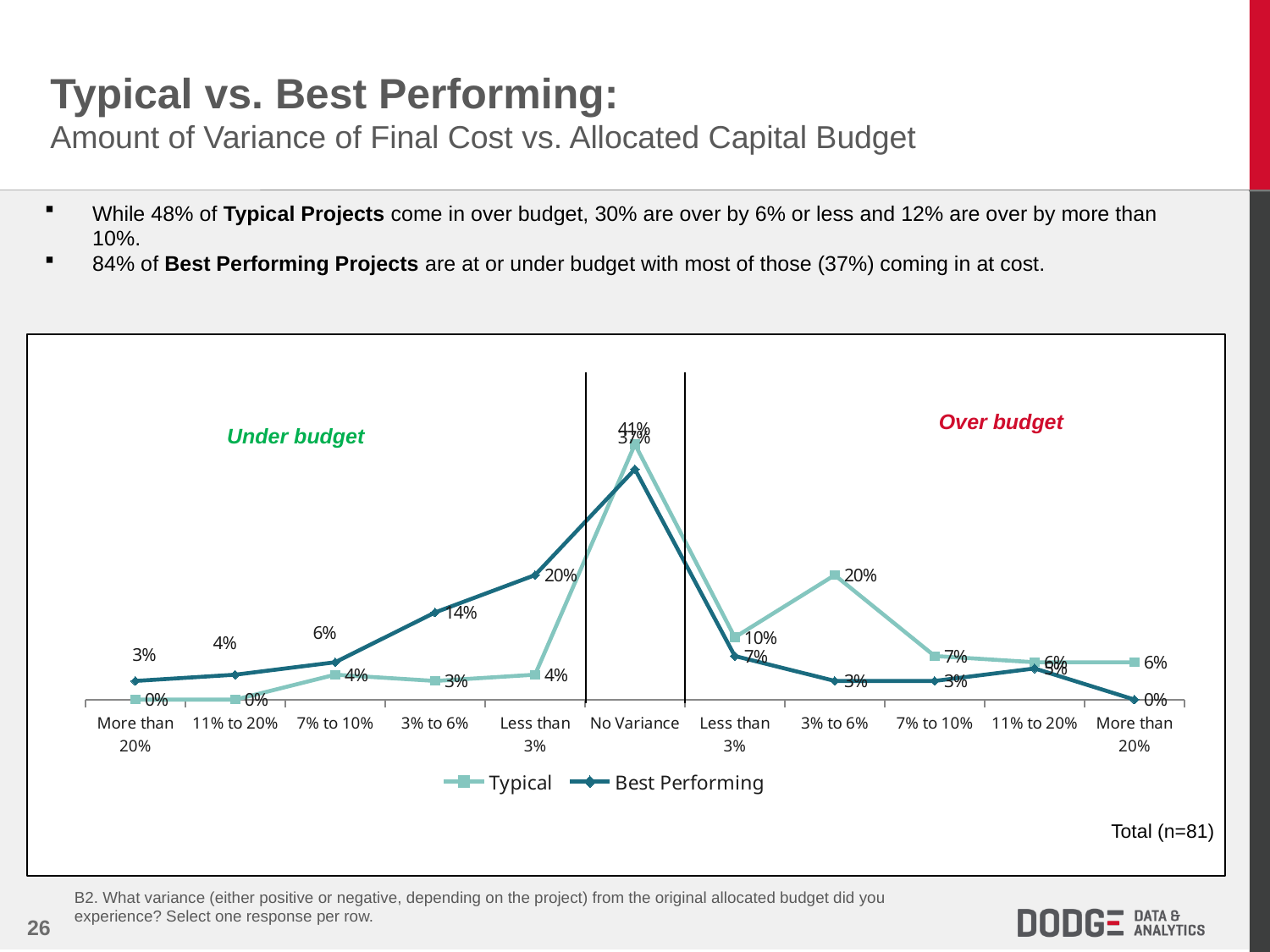
What is the value for Best Performing in the More than 20% over budget category? 0% What is the difference between the Typical and Best Performing values at No Variance? 4 percentage points What is the value for Typical at No Variance? 41% Which category has the highest value for the Typical series? No Variance How many series does the legend list? 2 What is the value for Typical in the 3% to 6% over budget category? 20% What is the difference between Best Performing and Typical in the 3% to 6% under budget category? 11 percentage points How many categories are shown along the x axis? 11 What kind of chart is shown on the slide? Line chart What is the value for Best Performing in the Less than 3% under budget category? 20% In the 3% to 6% over budget category, which series has the higher value, Typical or Best Performing? Typical What is the value for Best Performing at No Variance? 37%